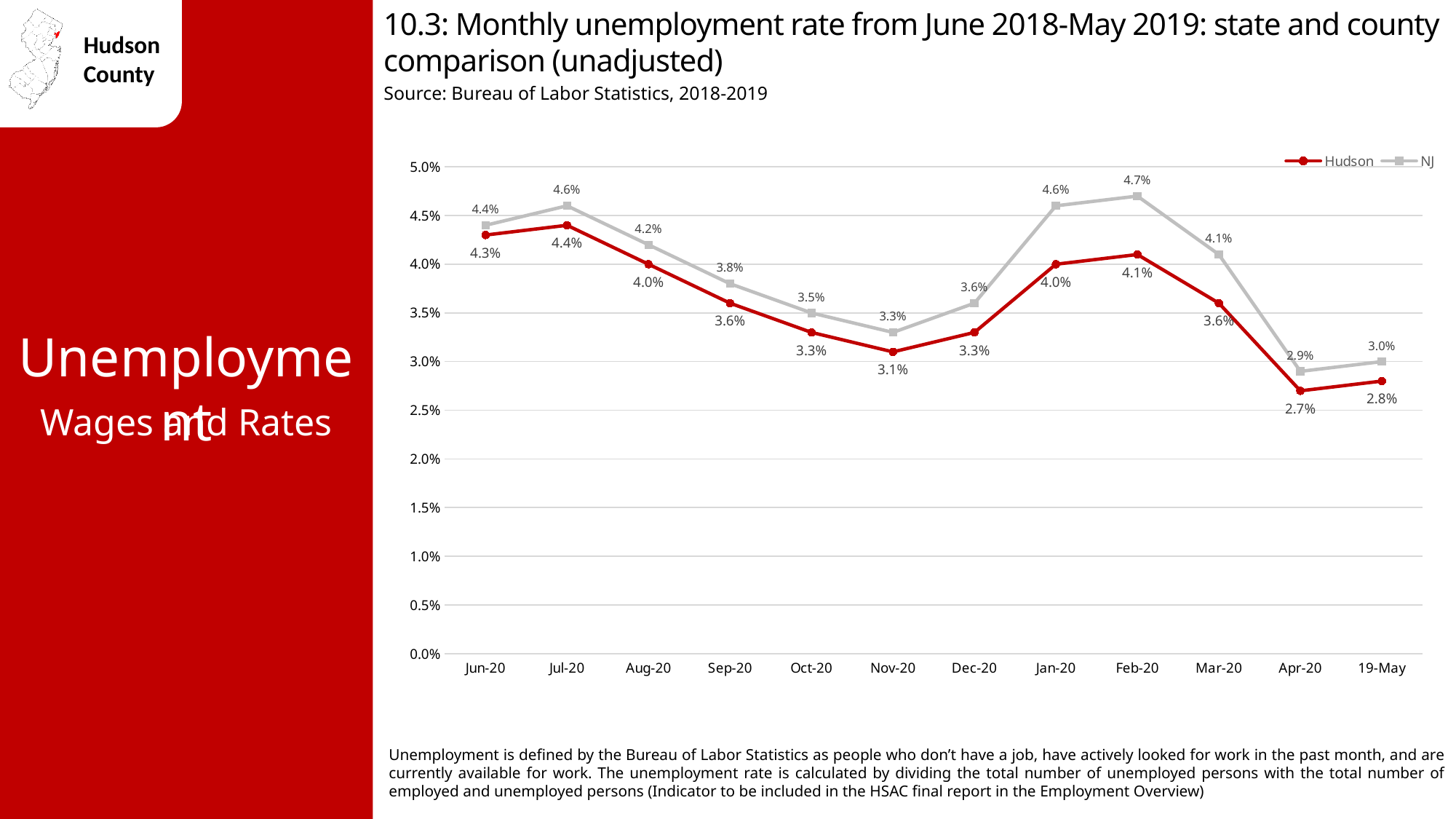
In which month is the Hudson unemployment rate lowest? Apr-20 Which colour is used for the Hudson line? Red What type of chart is shown on the slide? Line chart Does the Hudson unemployment rate rise or fall from Jul-20 to Nov-20? Fall Which series has the higher value in Dec-20, Hudson or NJ? NJ What is the difference between the NJ and Hudson unemployment rates in Jan-20? 0.6% What is the Hudson unemployment rate for Nov-20? 3.1% How many months are plotted along the x axis? 12 What is the Hudson unemployment rate for Apr-20? 2.7% In which month is the NJ unemployment rate highest? Feb-20 What is the NJ unemployment rate for Feb-20? 4.7% How many series does the legend list? 2